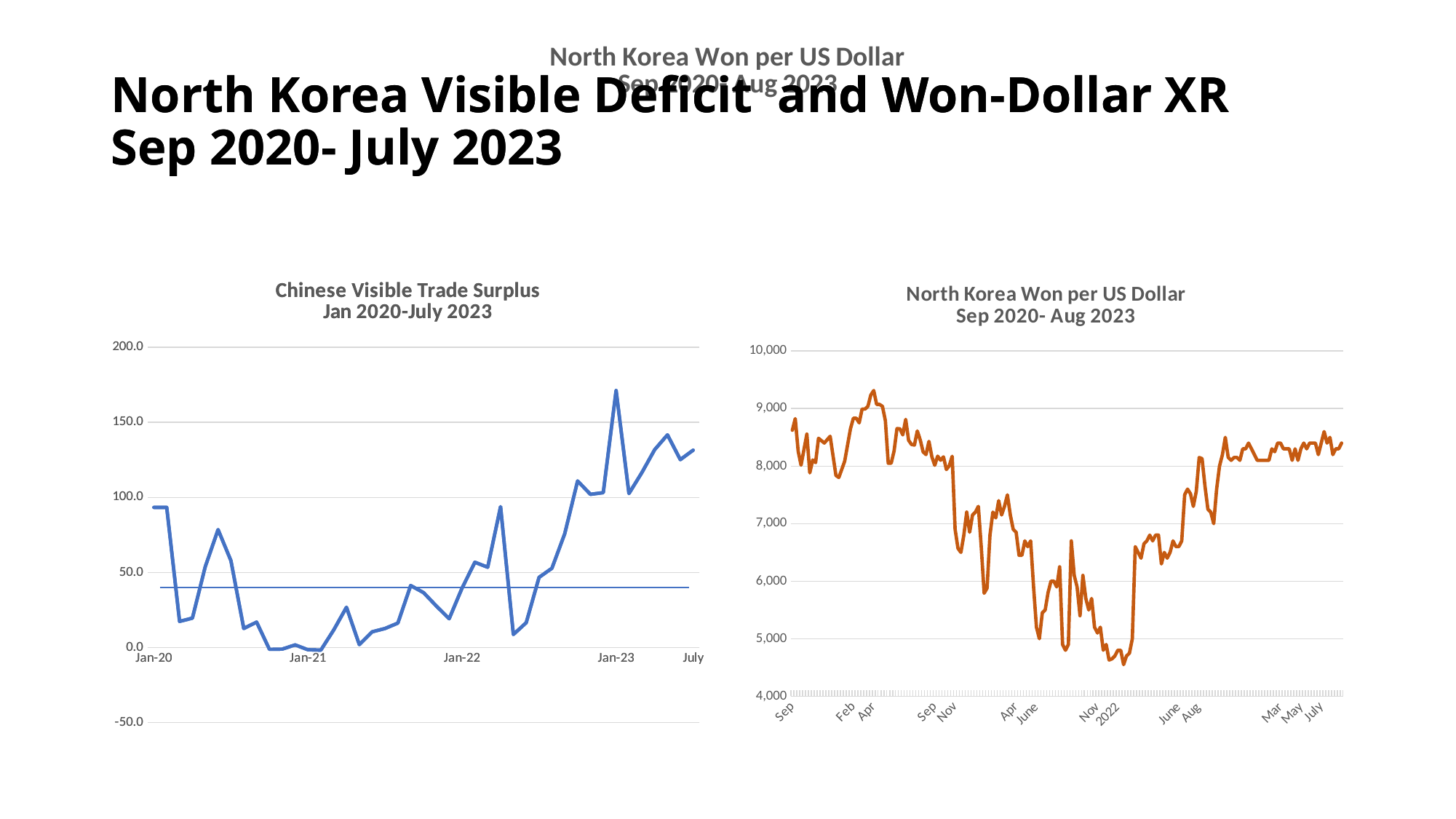
In the 'Chinese Visible Trade Surplus' chart, is the final value at July greater or less than 100? greater In the 'Chinese Visible Trade Surplus' chart, is the value at Jan-21 greater or less than 50? less In the 'North Korea Won per US Dollar' chart, is the lowest value (around Nov 2022) greater or less than 5,000? less In the 'Chinese Visible Trade Surplus' chart, does the series overall rise or fall between Jan-22 and Jan-23? rise In the 'North Korea Won per US Dollar' chart, does the exchange rate rise or fall between Nov 2022 and Aug 2023? rise What is the title of the chart on the left of the slide? Chinese Visible Trade Surplus Jan 2020-July 2023 What kind of chart is the 'North Korea Won per US Dollar' chart on the right? line chart What colour is the line in the 'North Korea Won per US Dollar' chart? orange What kind of chart is the 'Chinese Visible Trade Surplus' chart on the left? line chart